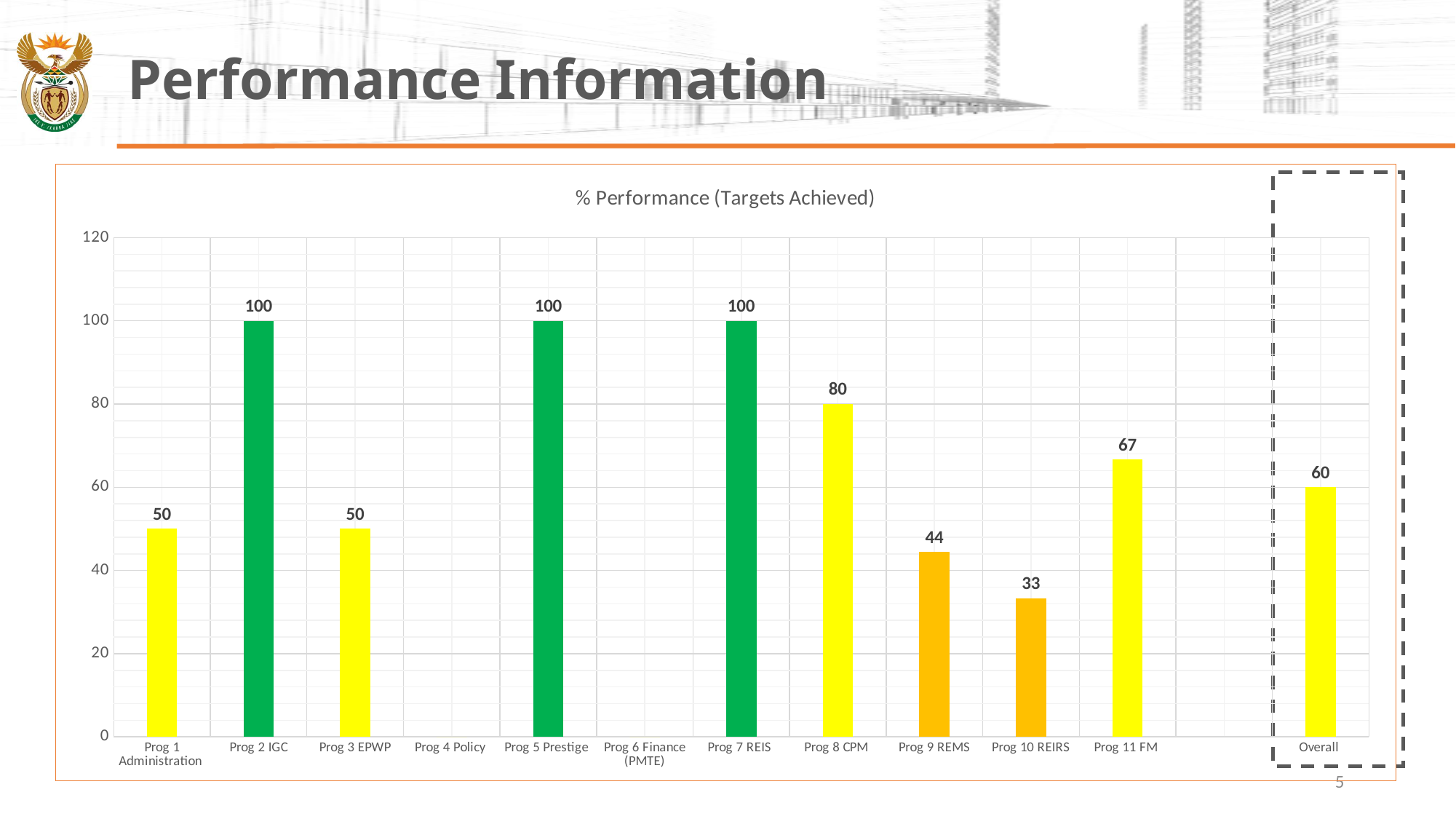
Which is larger, the value for Prog 11 FM or the value for Overall? Prog 11 FM What is the value for Prog 11 FM? 67 What kind of chart is shown on the slide? bar chart What is the title of the chart? % Performance (Targets Achieved) What is the value for Prog 10 REIRS? 33 What is the difference between the values for Prog 8 CPM and Prog 9 REMS? 36 What is the highest value shown on the chart? 100 Is the value for Prog 9 REMS greater or less than 60? less How many category labels are shown on the x axis? 12 What is the value for Prog 8 CPM? 80 What is the value for Overall? 60